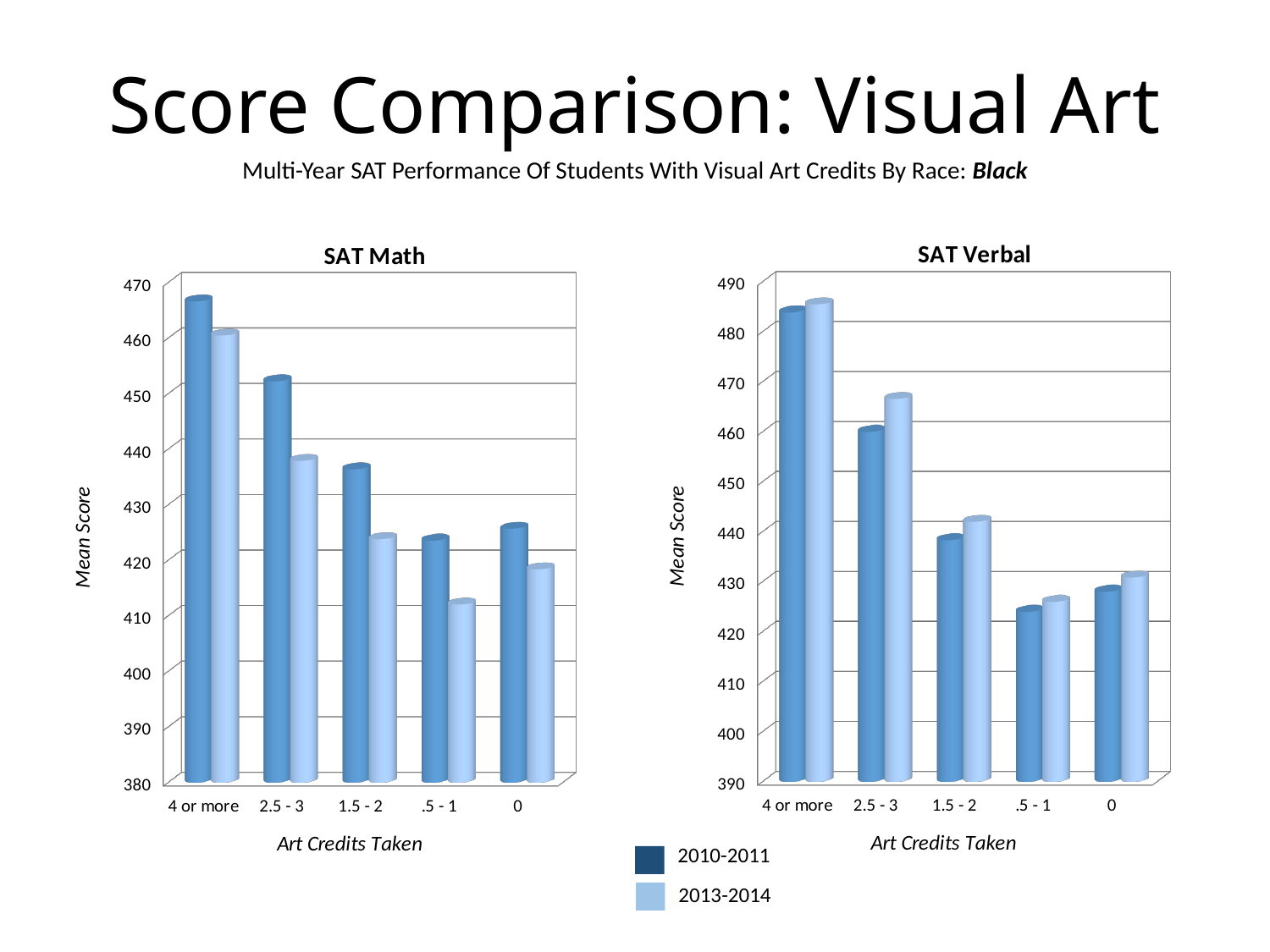
In the SAT Verbal chart, how many art-credit categories are shown on the x axis? 5 How many series does the legend list? 2 What kind of chart is the SAT Math chart? bar chart In the SAT Math chart, which art-credit category has the lowest 2013-2014 mean score? .5 - 1 In the SAT Math chart, for the 2.5 - 3 category, which series has the larger value, 2010-2011 or 2013-2014? 2010-2011 What is the x-axis title of the SAT Verbal chart? Art Credits Taken In the SAT Math chart, is the 2010-2011 value for 4 or more greater or less than 460? greater In the SAT Verbal chart, is the 2013-2014 value for 4 or more greater or less than 480? greater In the SAT Verbal chart, for the 2.5 - 3 category, which series has the larger value, 2010-2011 or 2013-2014? 2013-2014 In the SAT Math chart, which art-credit category has the highest 2010-2011 mean score? 4 or more In the SAT Math chart, do the 2013-2014 values generally rise or fall from 4 or more to .5 - 1? fall In the SAT Math chart, is the 2013-2014 value for .5 - 1 greater or less than 420? less